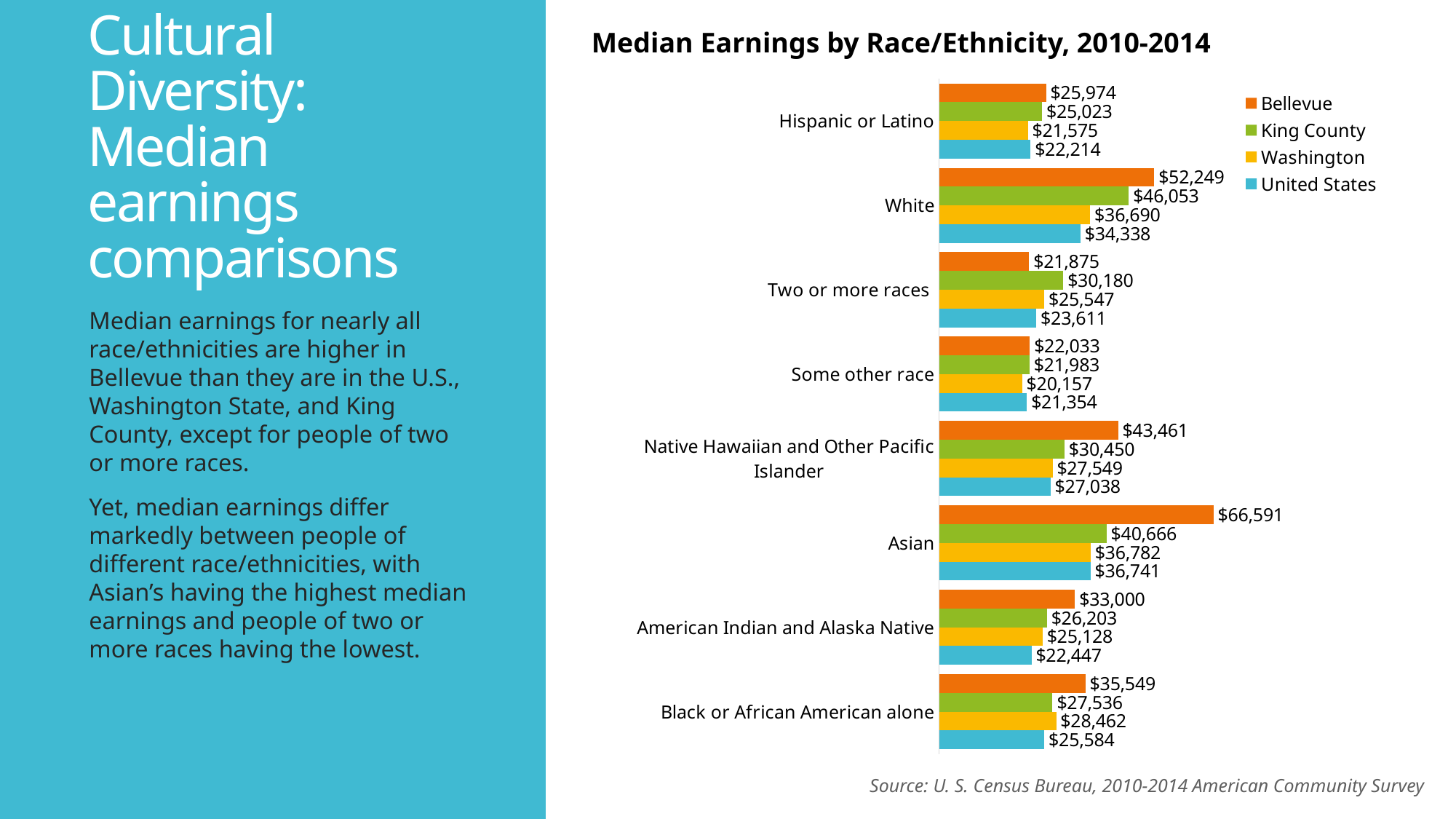
What is the median earnings value for White in Washington? $36,690 How many race/ethnicity categories are shown in the chart? 8 Which race/ethnicity has the highest King County median earnings? White Which race/ethnicity has the highest Bellevue median earnings? Asian What is the difference between the Bellevue and United States median earnings for Asian? $29,850 Which race/ethnicity has the lowest Bellevue median earnings? Two or more races For Two or more races, which is larger: the Bellevue value or the King County value? King County What is the United States median earnings value for Black or African American alone? $25,584 What is the difference between the Bellevue and King County median earnings for White? $6,196 What kind of chart is shown on the slide? Bar chart How many series does the legend list? 4 What is the median earnings value for Asian in Bellevue? $66,591